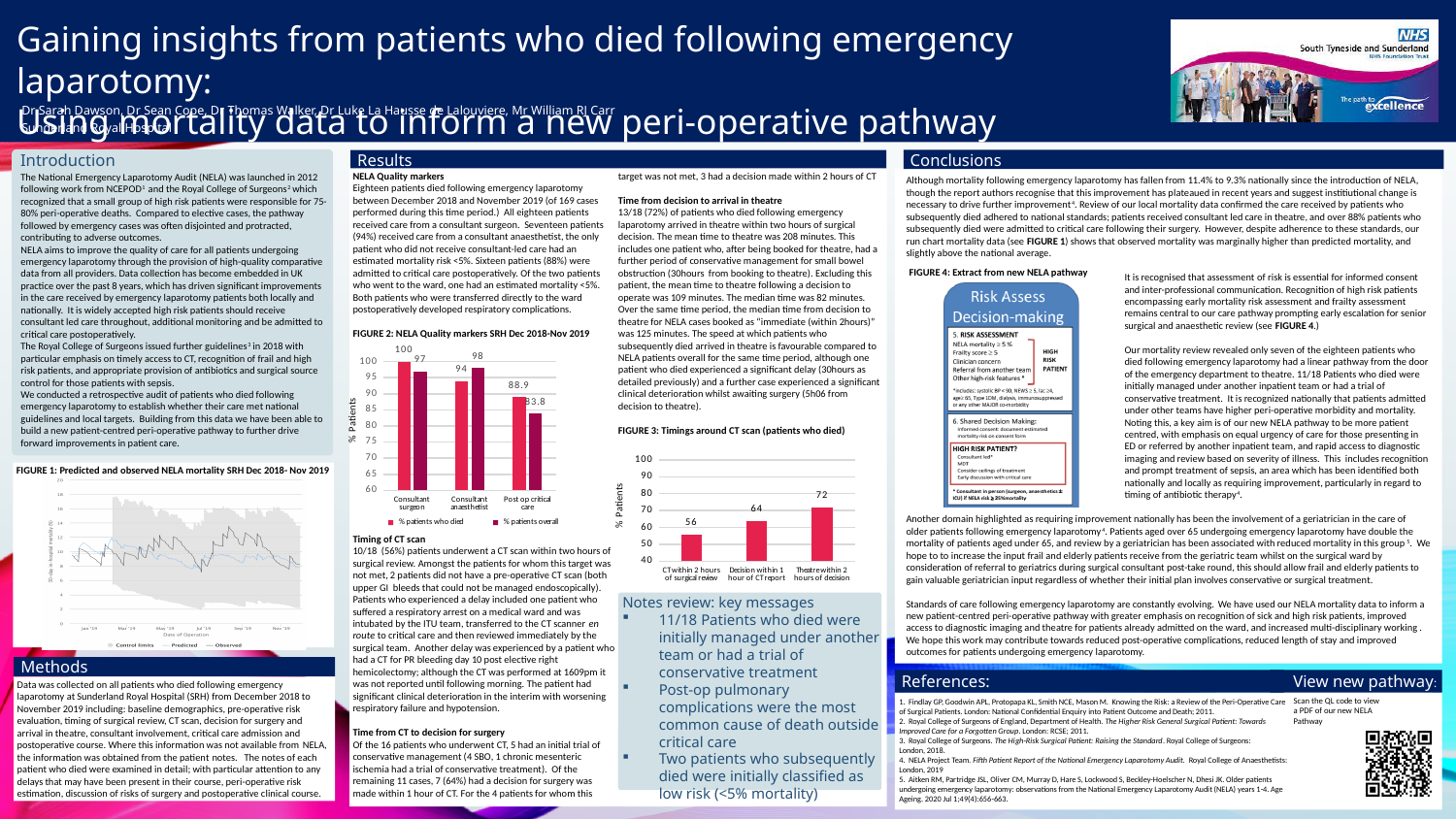
In FIGURE 3 (Timings around CT scan), which category has the lowest value? CT within 2 hours of surgical review In FIGURE 3 (Timings around CT scan), which category has the highest value? Theatre within 2 hours of decision In FIGURE 3 (Timings around CT scan), what is the value for 'CT within 2 hours of surgical review'? 56 In FIGURE 3 (Timings around CT scan), what is the difference between 'Theatre within 2 hours of decision' and 'CT within 2 hours of surgical review'? 16 In FIGURE 2 (NELA Quality markers), how many series does the legend list? 2 In FIGURE 3 (Timings around CT scan), do the values rise or fall from left to right along the x axis? rise What kind of chart is FIGURE 2 (NELA Quality markers)? bar chart In FIGURE 2 (NELA Quality markers), what is the '% patients overall' value for Post op critical care? 83.8 In FIGURE 3 (Timings around CT scan), what is the value for 'Theatre within 2 hours of decision'? 72 In FIGURE 2 (NELA Quality markers), what is the '% patients who died' value for Post op critical care? 88.9 In FIGURE 2 (NELA Quality markers), what is the '% patients who died' value for Consultant anaesthetist? 94 In FIGURE 3 (Timings around CT scan), how many categories are plotted? 3